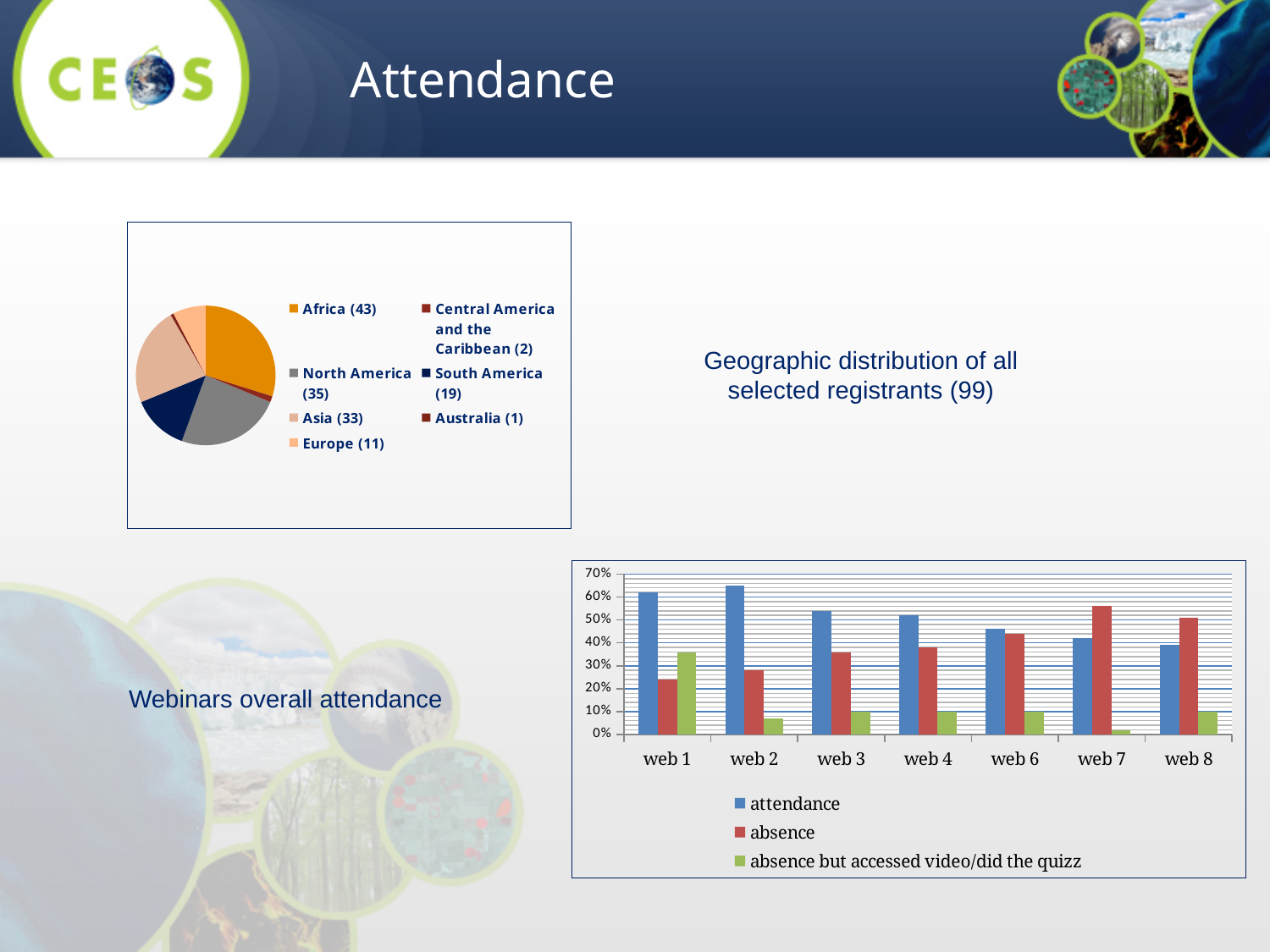
In the webinars overall attendance chart, how many webinars are shown on the x axis? 7 In the pie chart on the geographic distribution of registrants, how many registrants are from South America? 19 In the webinars overall attendance chart, what kind of chart is shown? Bar chart In the webinars overall attendance chart, which webinar has the highest value for 'absence but accessed video/did the quizz'? web 1 In the pie chart on the geographic distribution of registrants, how many registrants are from Africa? 43 In the pie chart on the geographic distribution of registrants, which region has the fewest registrants? Australia (1) In the webinars overall attendance chart, how many series does the legend list? 3 In the pie chart on the geographic distribution of registrants, which region has the most registrants? Africa (43) In the pie chart on the geographic distribution of registrants, how many regions are listed in the legend? 7 In the webinars overall attendance chart, for web 7, which is larger: attendance or absence? absence In the pie chart on the geographic distribution of registrants, how many more registrants are from Africa than from North America? 8 In the webinars overall attendance chart, is the attendance value for web 2 greater or less than 60%? greater